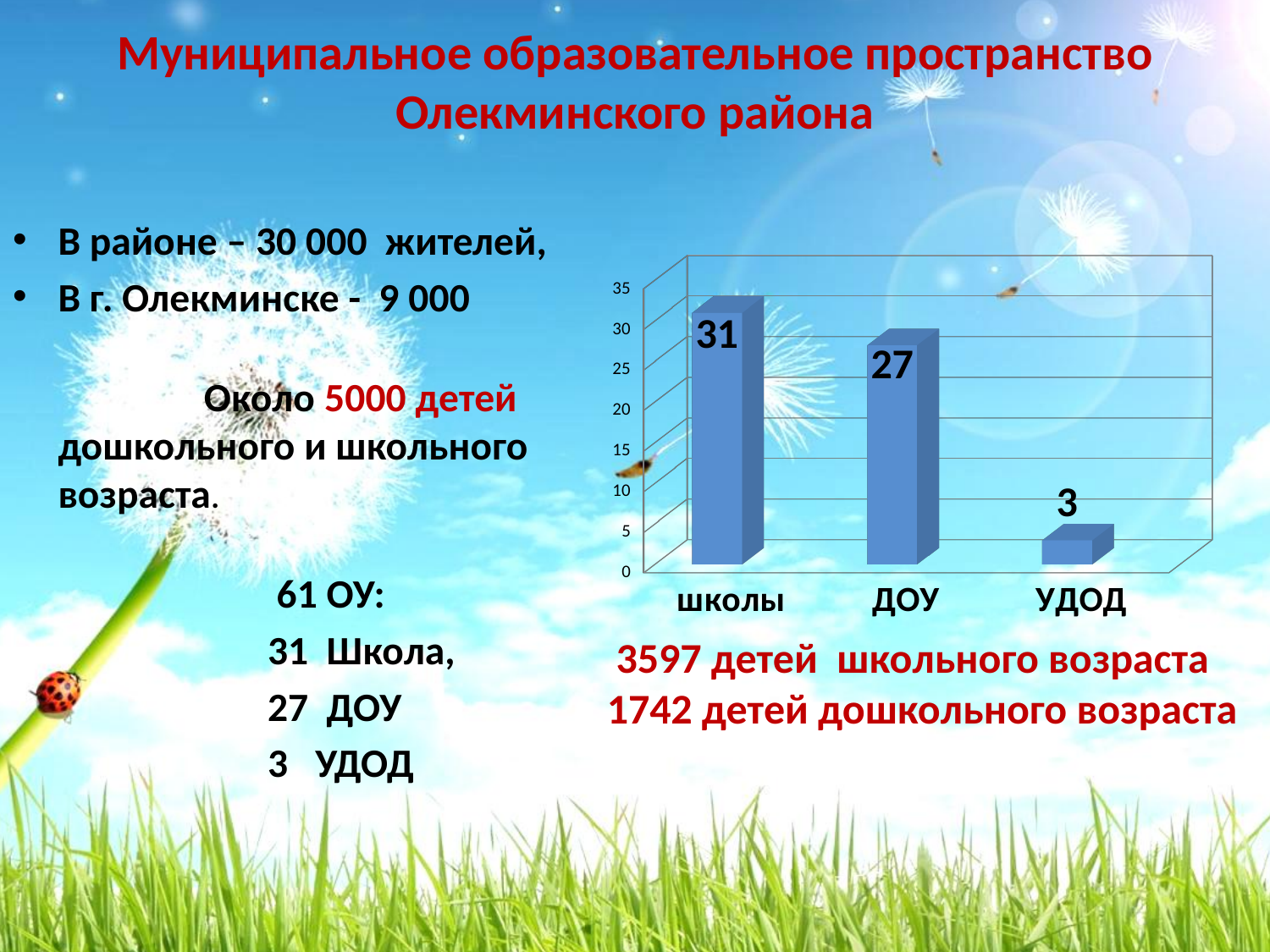
What is the value for УДОД? 3 Which is larger, the value for школы or the value for ДОУ? школы Which category has the highest value? школы Do the values rise or fall from left to right along the x axis? fall What is the difference between the values for ДОУ and УДОД? 24 How many categories are shown on the chart? 3 What is the difference between the values for школы and ДОУ? 4 What is the value for ДОУ? 27 What kind of chart is shown on the slide? bar chart Which category has the lowest value? УДОД What is the value for школы? 31 Is the value for ДОУ greater or less than 25? greater